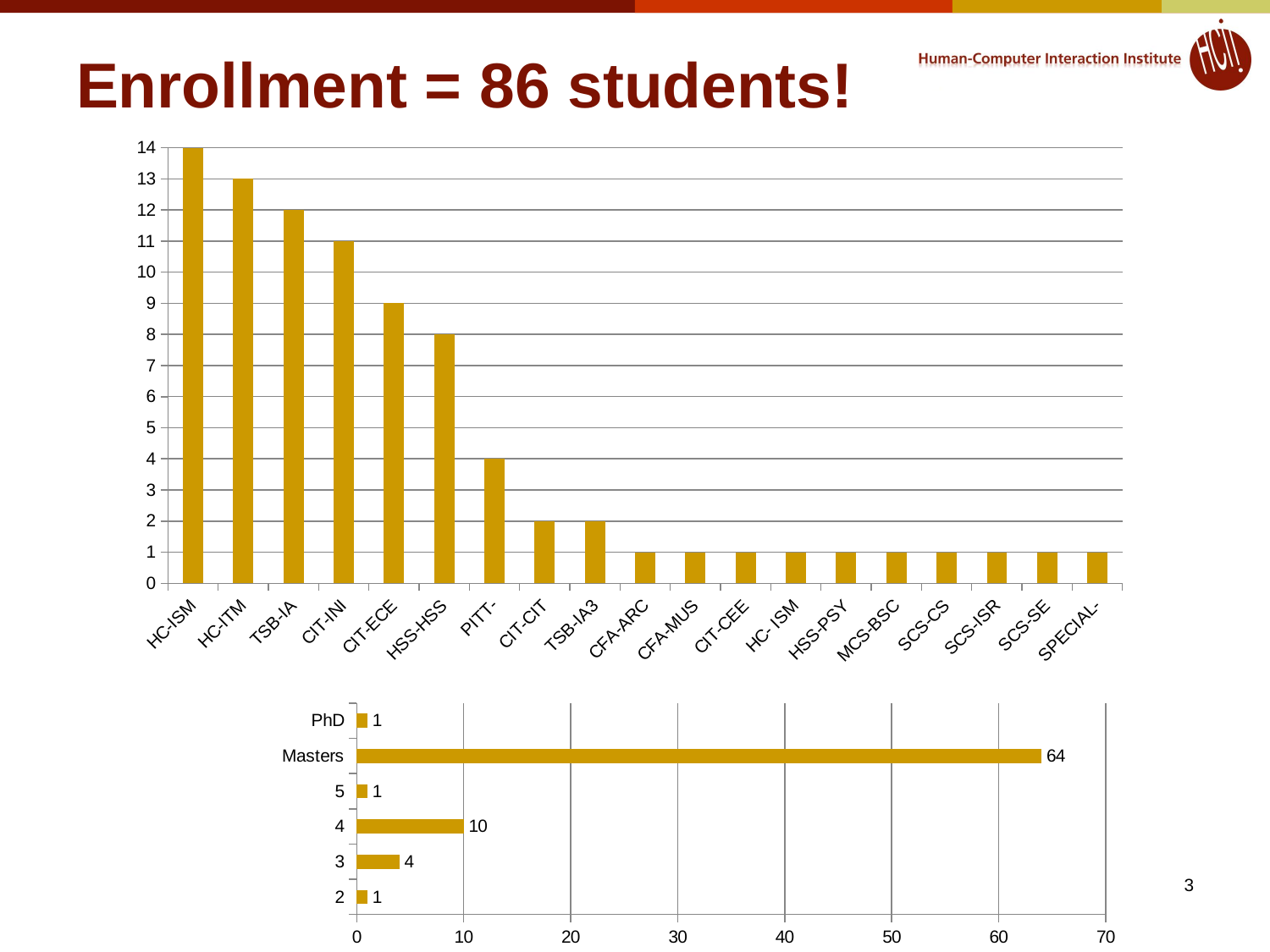
In the bottom chart, what is the difference between the values for Masters and category 4? 54 In the top chart, do the values rise or fall from left to right along the x axis? fall In the top chart, what is the value for PITT-? 4 In the top chart, what is the value for HC-ITM? 13 What kind of chart is the bottom chart? bar chart In the top chart, which is larger, the value for CIT-INI or the value for CIT-CIT? CIT-INI In the top chart, what is the difference between the values for TSB-IA and HSS-HSS? 4 In the top chart, how many categories are shown on the x axis? 19 In the top chart, which category has the highest value? HC-ISM In the top chart, what is the value for CIT-ECE? 9 In the bottom chart, what is the value for category 4? 10 In the bottom chart, what is the value for Masters? 64